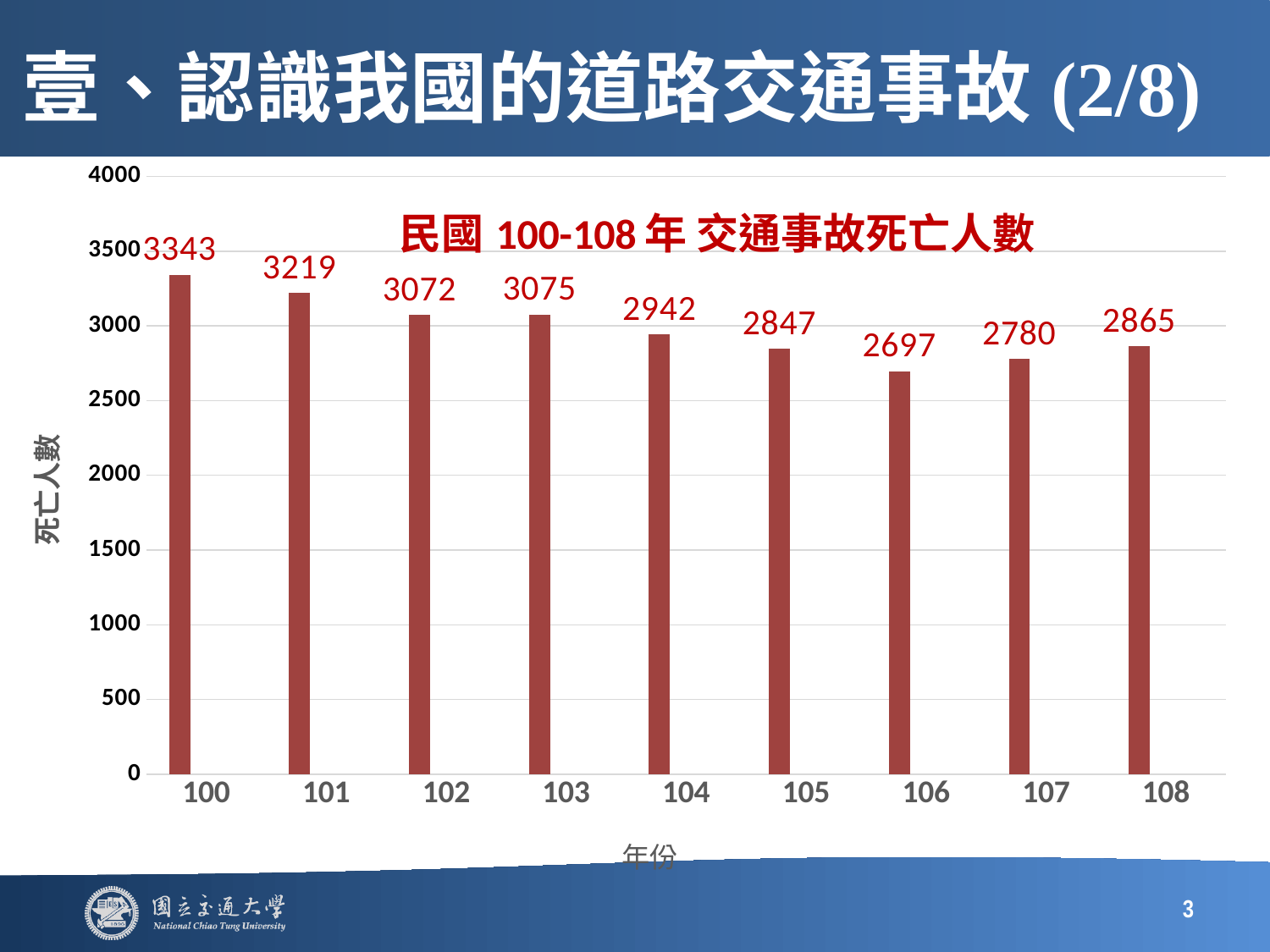
Which year has the lowest number of deaths? 106 How many years are shown on the x axis? 9 What kind of chart is shown on the slide? bar chart What is the value shown for year 104? 2942 Which year has the highest number of deaths? 100 What is the title of the chart? 民國 100-108 年 交通事故死亡人數 What is the number of traffic accident deaths for year 100? 3343 What is the difference between the values for year 107 and year 106? 83 Is the value for year 103 greater or less than 3000? greater What is the number of traffic accident deaths for year 106? 2697 What is the difference between the values for year 100 and year 108? 478 Which is larger, the value for year 101 or the value for year 105? 101